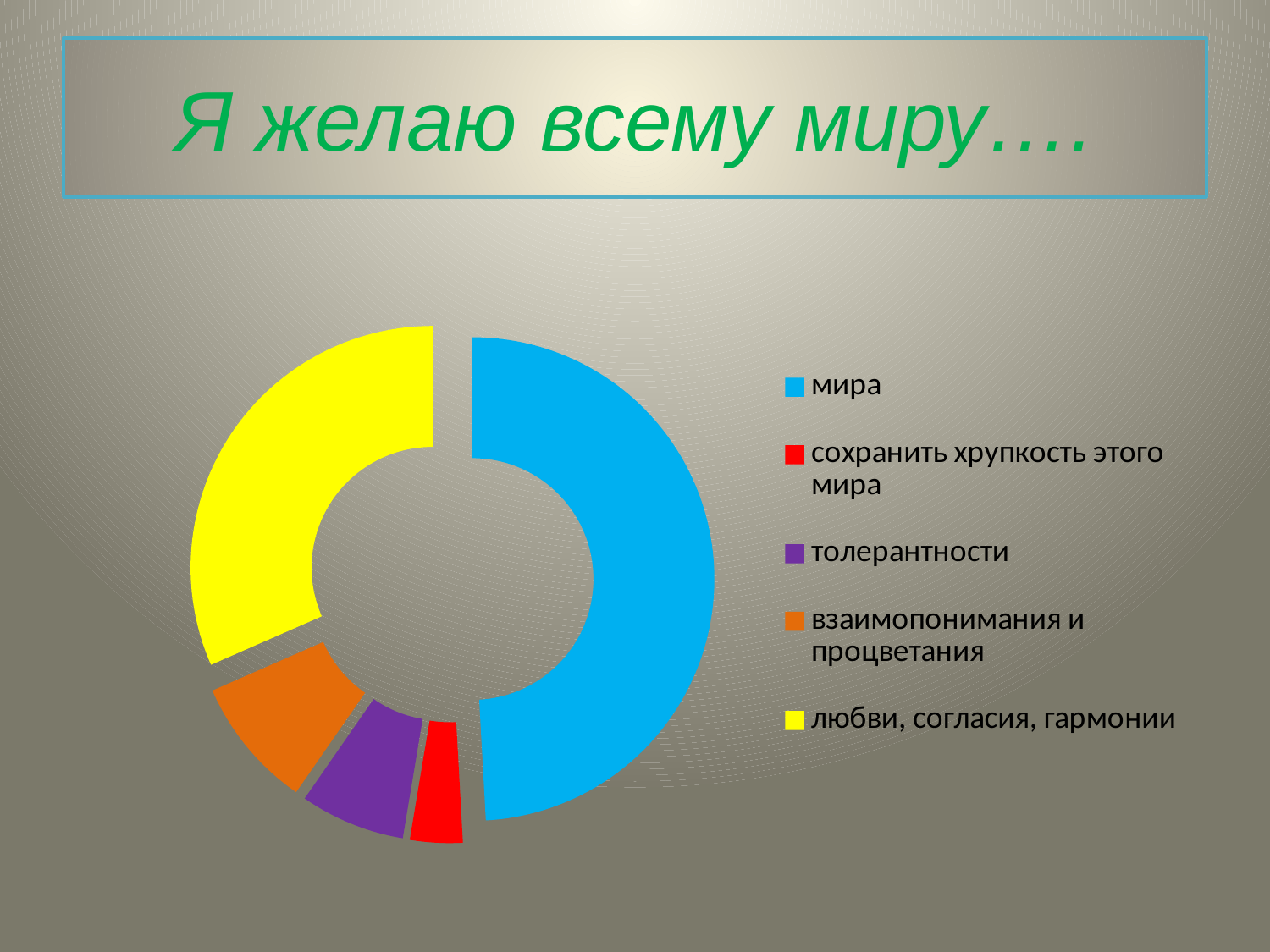
What is the title of the slide containing the chart? Я желаю всему миру…. Which is larger: the share for "взаимопонимания и процветания" or the share for "сохранить хрупкость этого мира"? взаимопонимания и процветания Which is larger: the share for "толерантности" or the share for "сохранить хрупкость этого мира"? толерантности Which is larger: the share for "любви, согласия, гармонии" or the share for "взаимопонимания и процветания"? любви, согласия, гармонии How many categories does the chart show? 5 Which category has the smallest share of the chart? сохранить хрупкость этого мира What kind of chart is shown on the slide? doughnut chart Which category has the largest share of the chart? мира What colour represents "мира" in the chart? blue